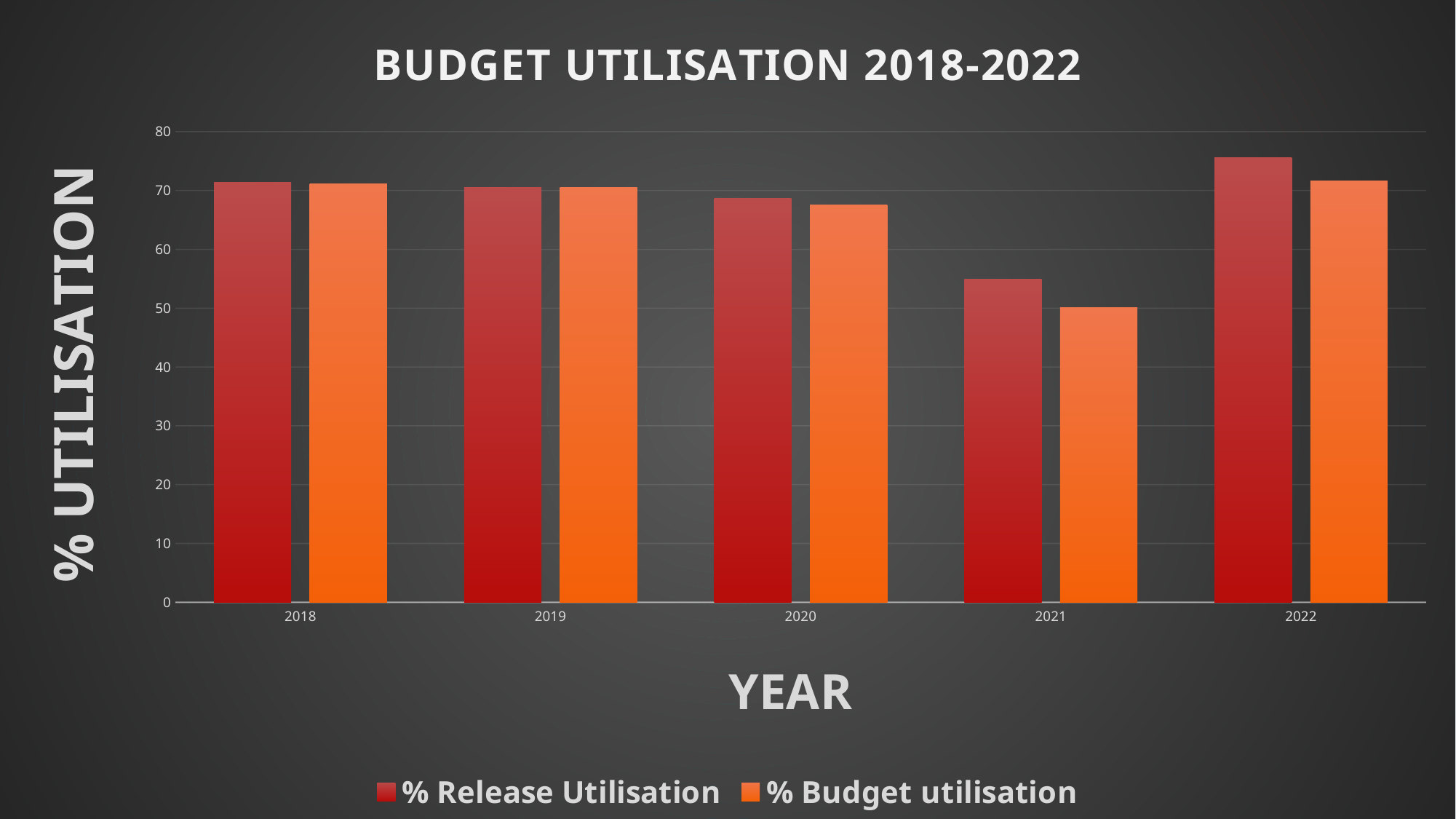
What kind of chart is shown on the slide? bar chart What is the title of the chart? BUDGET UTILISATION 2018-2022 Is the % Budget utilisation for 2021 greater or less than 60? less From 2018 to 2021, does % Release Utilisation rise or fall? fall Is the % Release Utilisation for 2022 greater or less than 70? greater Which year has the lowest % Budget utilisation? 2021 How many years are shown on the x axis? 5 How many series does the legend list? 2 Which year has the lowest % Release Utilisation? 2021 Which year has the highest % Release Utilisation? 2022 In 2021, which is larger: % Release Utilisation or % Budget utilisation? % Release Utilisation Is the % Budget utilisation for 2020 greater or less than 70? less